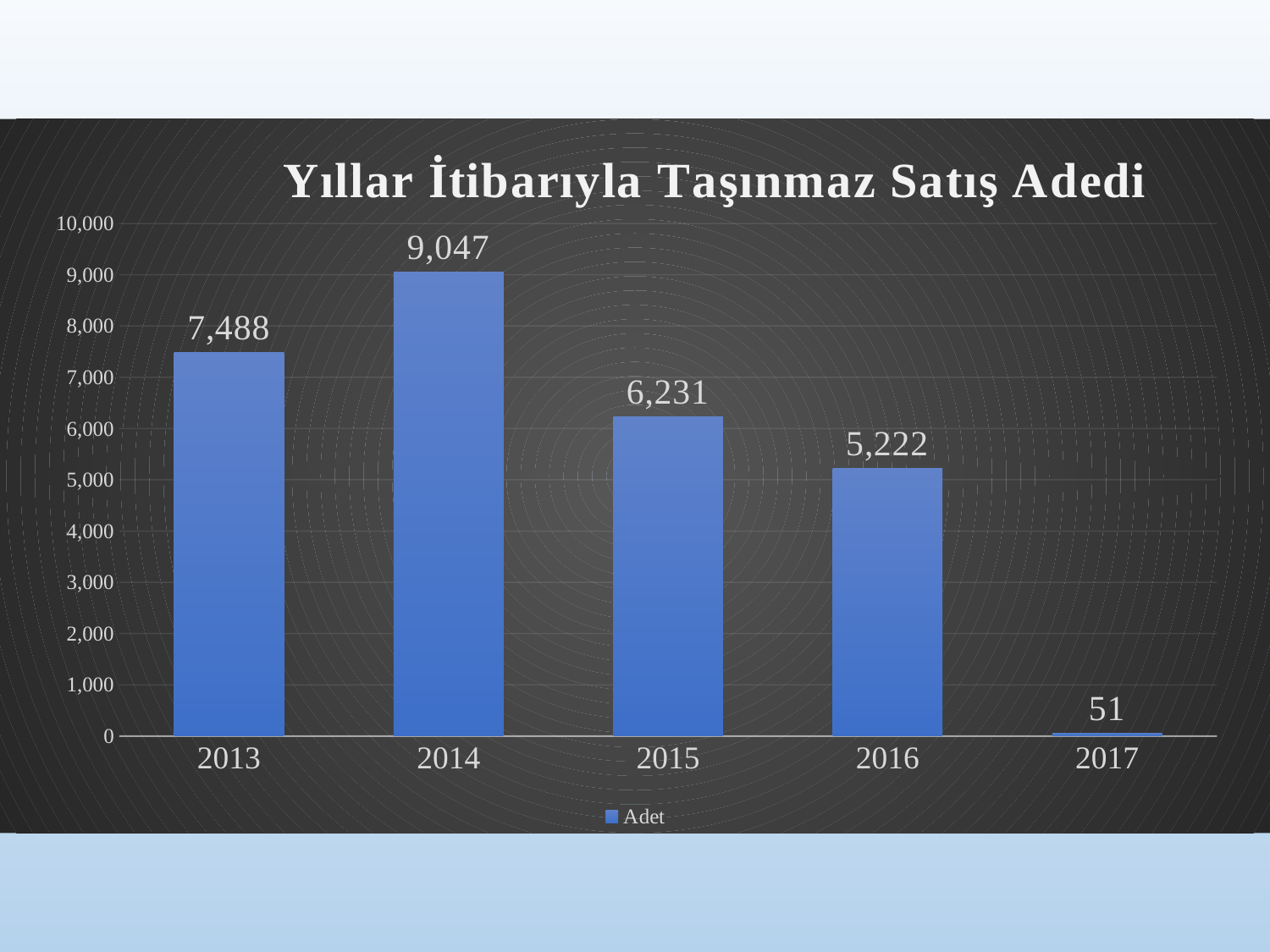
What is the value for 2016? 5,222 How many series does the legend list? 1 What is the value for 2014? 9,047 What is the title of the chart? Yıllar İtibarıyla Taşınmaz Satış Adedi What is the value for 2017? 51 What kind of chart is shown? bar chart What is the difference between the values for 2015 and 2016? 1,009 Which year has the highest value? 2014 Which is larger, the value for 2013 or the value for 2015? 2013 How many years are shown on the x axis? 5 What is the difference between the values for 2014 and 2013? 1,559 Which year has the lowest value? 2017